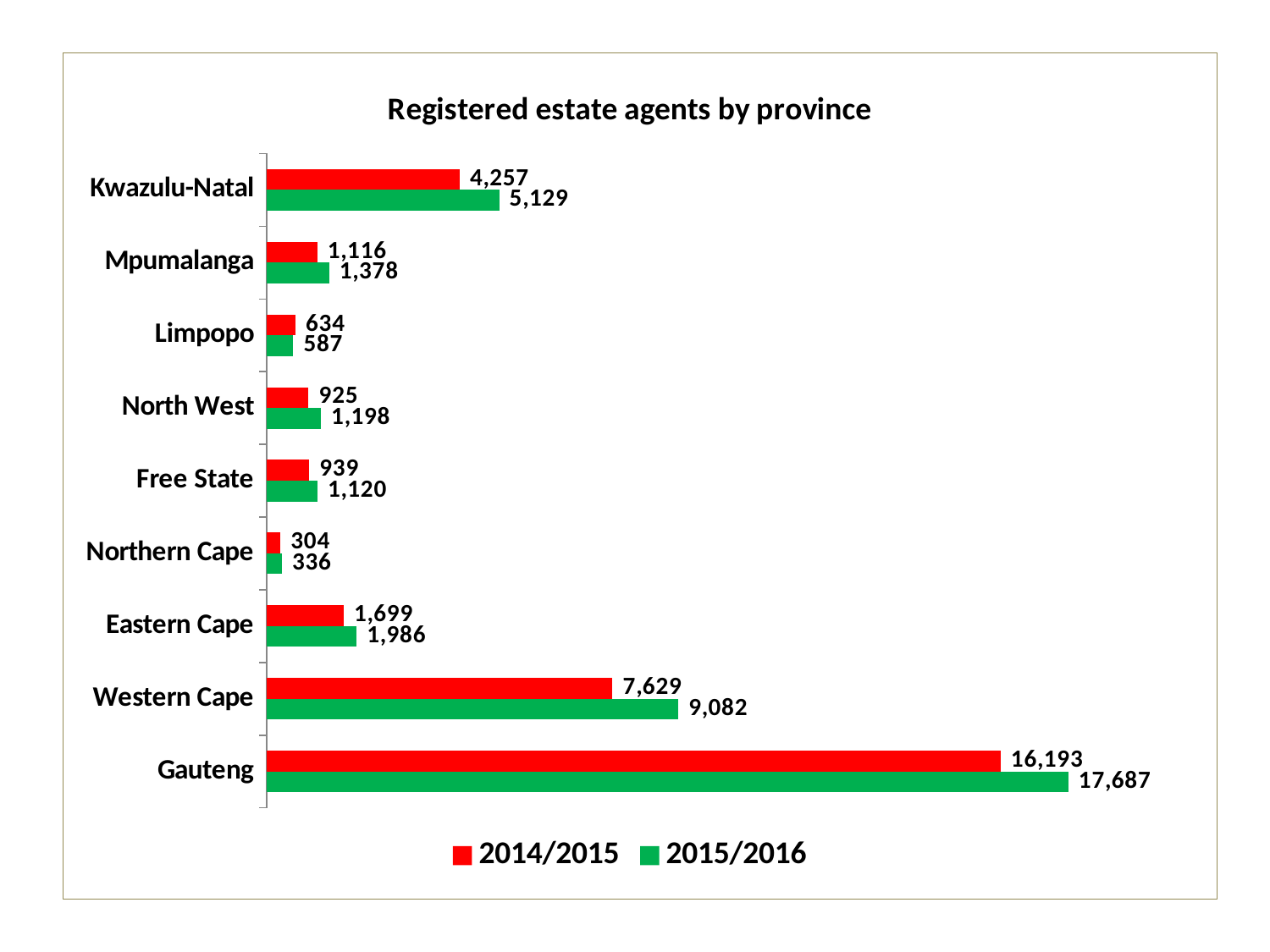
What is the value for Western Cape in 2014/2015? 7,629 Which province has the highest value in 2015/2016? Gauteng How many provinces are shown on the chart? 9 What is the difference between the 2014/2015 and 2015/2016 values for Limpopo? 47 How many series does the legend list? 2 Which is larger: Eastern Cape in 2015/2016 or Mpumalanga in 2015/2016? Eastern Cape Which is larger for Limpopo: the 2014/2015 value or the 2015/2016 value? 2014/2015 What is the value for Limpopo in 2015/2016? 587 Which province has the lowest value in 2014/2015? Northern Cape What type of chart is shown? Bar chart What is the difference between the 2015/2016 and 2014/2015 values for Kwazulu-Natal? 872 What is the value for Gauteng in 2015/2016? 17,687